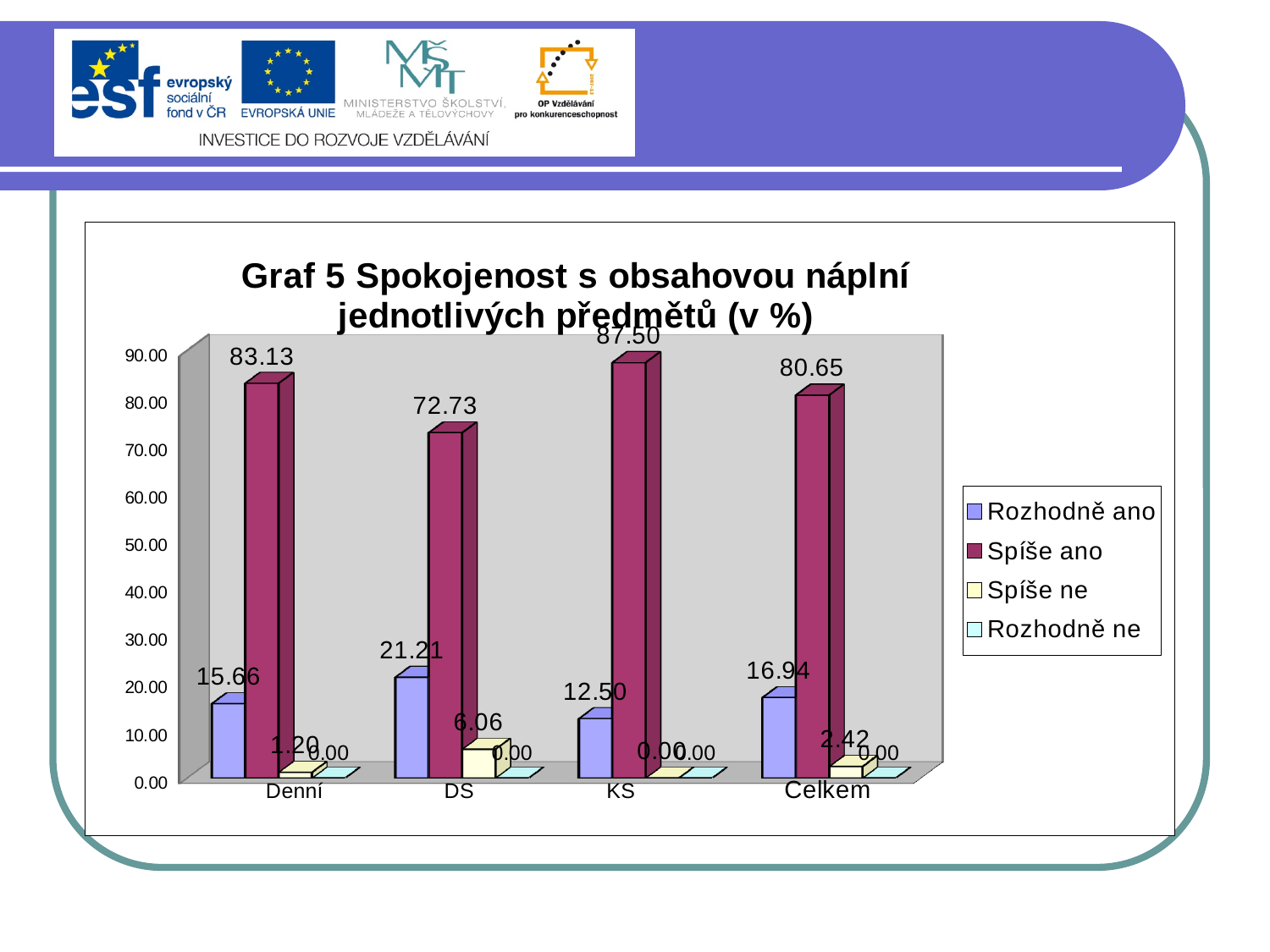
How many series does the legend list? 4 How many categories are shown on the x axis? 4 Which is larger, Rozhodně ano for Denní or Rozhodně ano for Celkem? Celkem What is the difference between the Spíše ano values for KS and DS? 14.77 What kind of chart is shown? bar chart What is the value of Spíše ne for Celkem? 2.42 What is the value of Spíše ano for KS? 87.50 Is the value of Spíše ano for DS greater or less than 70.00? greater Which category has the lowest value for Rozhodně ano? KS What is the value of Spíše ano for Denní? 83.13 What is the value of Rozhodně ano for DS? 21.21 Which category has the highest value for Spíše ano? KS